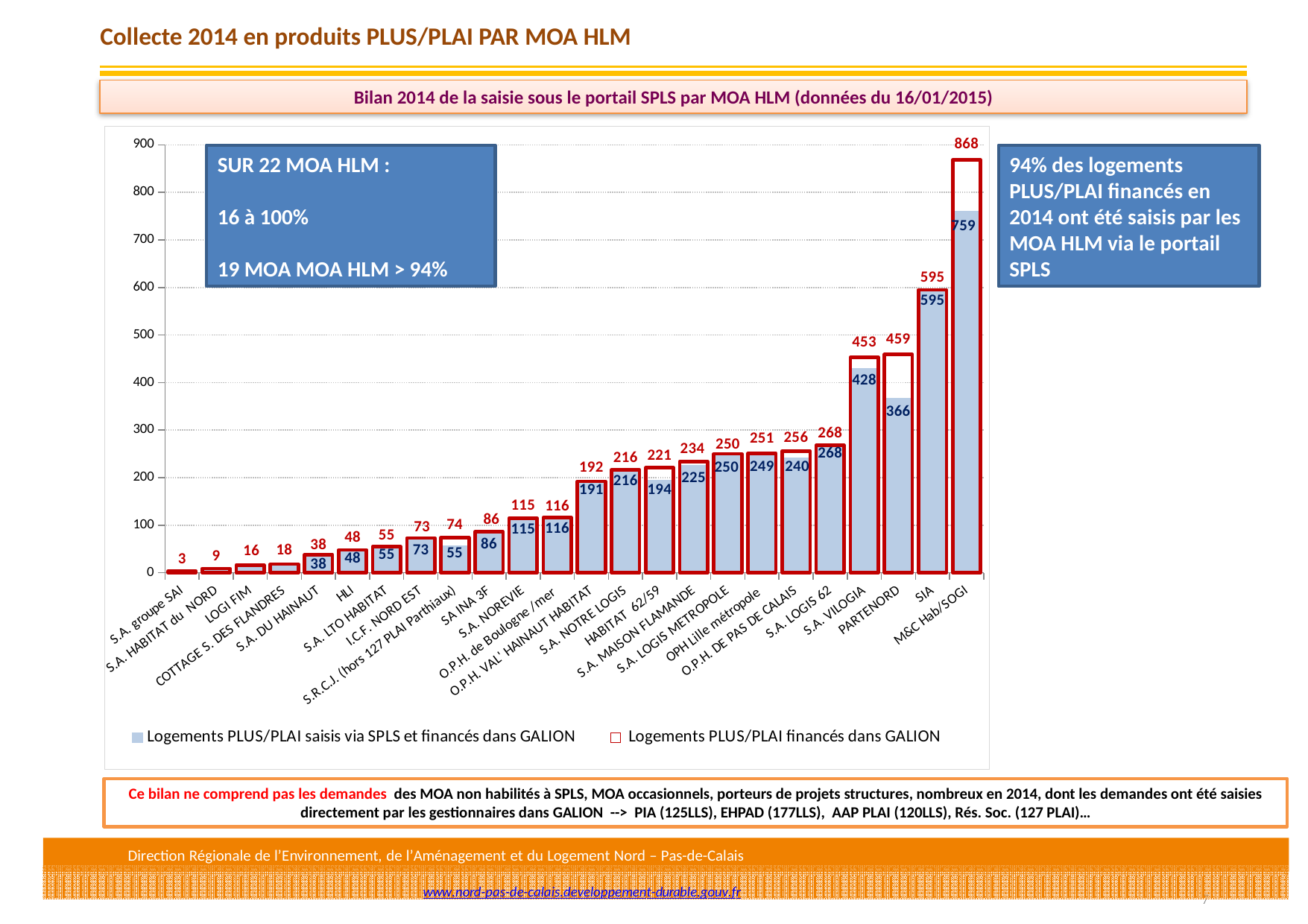
Do the values of 'Logements PLUS/PLAI financés dans GALION' rise or fall from left to right along the x axis? Rise Which MOA HLM has the highest value of 'Logements PLUS/PLAI financés dans GALION'? M&C Hab/SOGI For PARTENORD, what is the difference between 'Logements PLUS/PLAI financés dans GALION' and 'Logements PLUS/PLAI saisis via SPLS et financés dans GALION'? 93 What kind of chart is shown on the slide? Bar chart Which MOA HLM has the lowest value of 'Logements PLUS/PLAI financés dans GALION'? S.A. groupe SAI How many series does the chart legend list? 2 For S.A. VILOGIA, what is the difference between 'Logements PLUS/PLAI financés dans GALION' and 'Logements PLUS/PLAI saisis via SPLS et financés dans GALION'? 25 What is the value of 'Logements PLUS/PLAI financés dans GALION' for SIA? 595 What is the value of 'Logements PLUS/PLAI financés dans GALION' for M&C Hab/SOGI? 868 Which has the larger value of 'Logements PLUS/PLAI financés dans GALION': S.A. VILOGIA or PARTENORD? PARTENORD What is the value of 'Logements PLUS/PLAI saisis via SPLS et financés dans GALION' for HABITAT 62/59? 194 What is the value of 'Logements PLUS/PLAI saisis via SPLS et financés dans GALION' for PARTENORD? 366